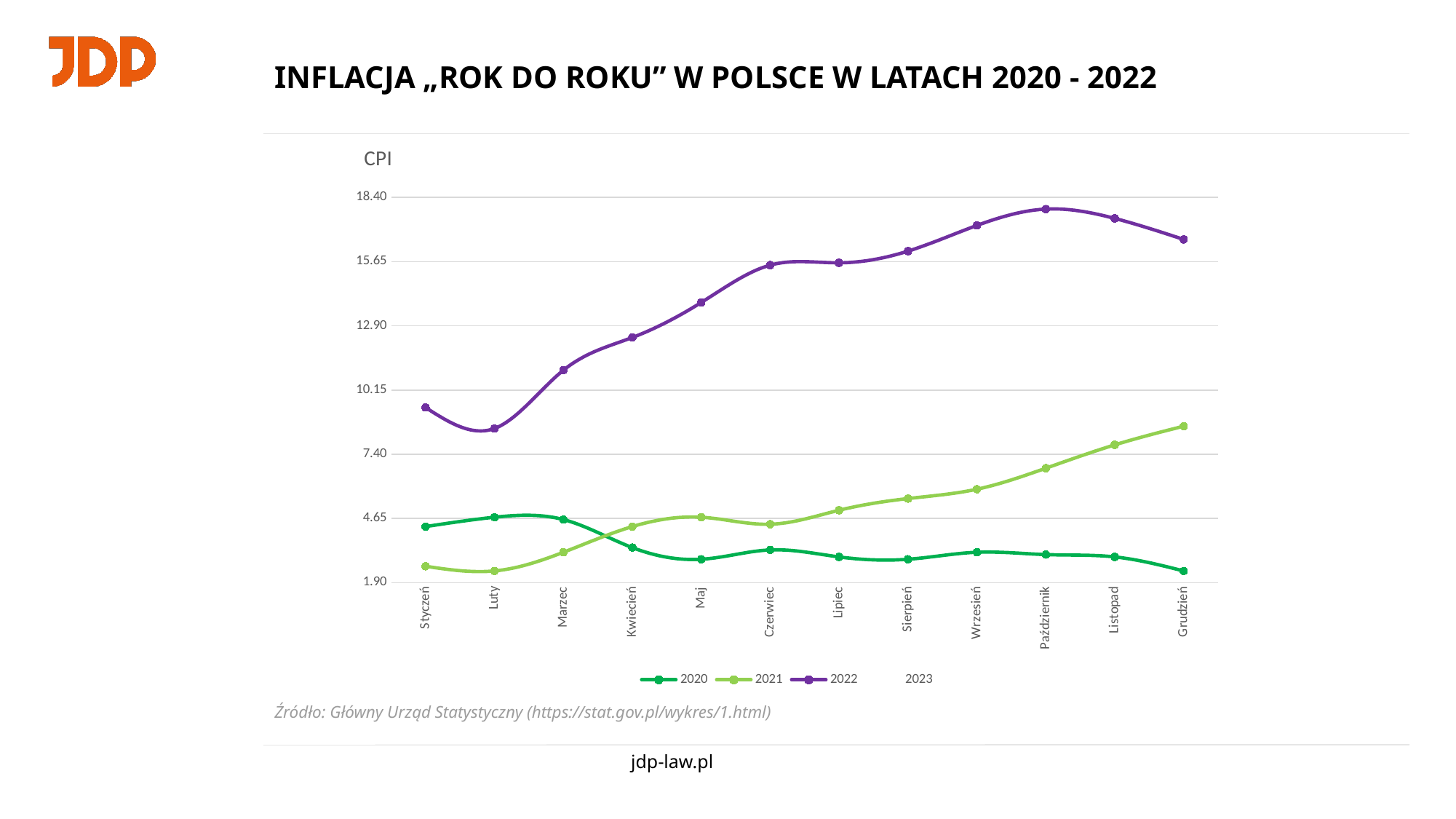
In Styczeń, which series has the higher value, 2020 or 2021? 2020 Is the value for 2022 in Styczeń greater or less than 10.15? less In which month does the 2022 line reach its highest value? Październik What kind of chart is shown on the slide? line chart In which month does the 2021 line reach its highest value? Grudzień In which month does the 2021 line reach its lowest value? Luty How many lines are plotted on the chart? 3 Is the value for 2021 in Grudzień greater or less than 7.40? greater Is the value for 2022 in Grudzień greater or less than 15.65? greater In which month does the 2022 line reach its lowest value? Luty Does the 2021 line generally rise or fall from Styczeń to Grudzień? rise How many months are shown along the x axis? 12